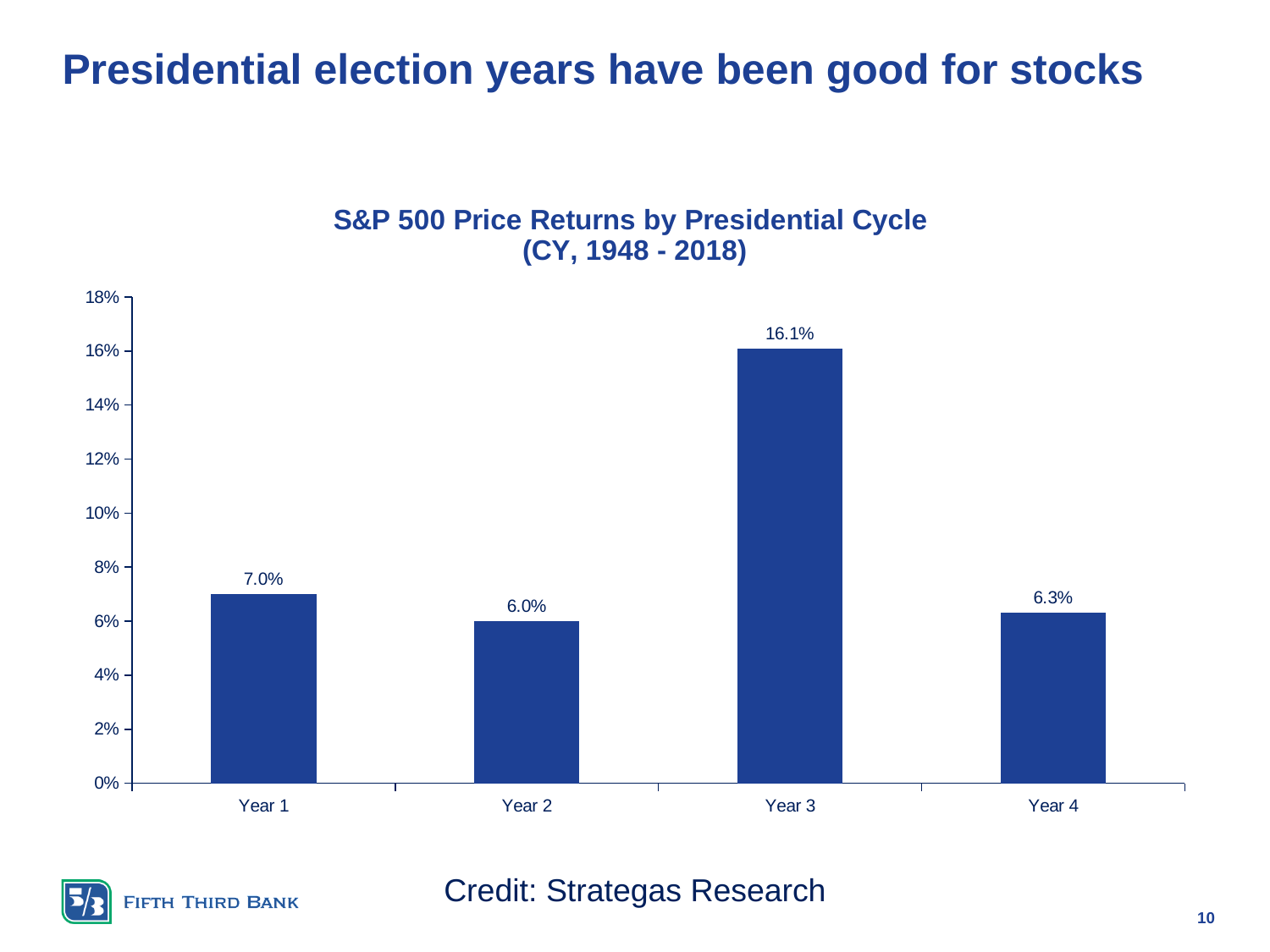
Which year of the presidential cycle has the highest S&P 500 price return? Year 3 What is the difference between the Year 3 and Year 2 returns? 10.1% What is the S&P 500 price return for Year 1? 7.0% Which has a higher return, Year 1 or Year 4? Year 1 What is the S&P 500 price return for Year 4? 6.3% What is the title of the chart? S&P 500 Price Returns by Presidential Cycle (CY, 1948 - 2018) Which year of the presidential cycle has the lowest S&P 500 price return? Year 2 What is the S&P 500 price return for Year 3? 16.1% What is the difference between the Year 1 and Year 4 returns? 0.7% What kind of chart is shown on the slide? Bar chart Is the value for Year 3 greater or less than 14%? greater How many years of the presidential cycle are shown on the chart? 4